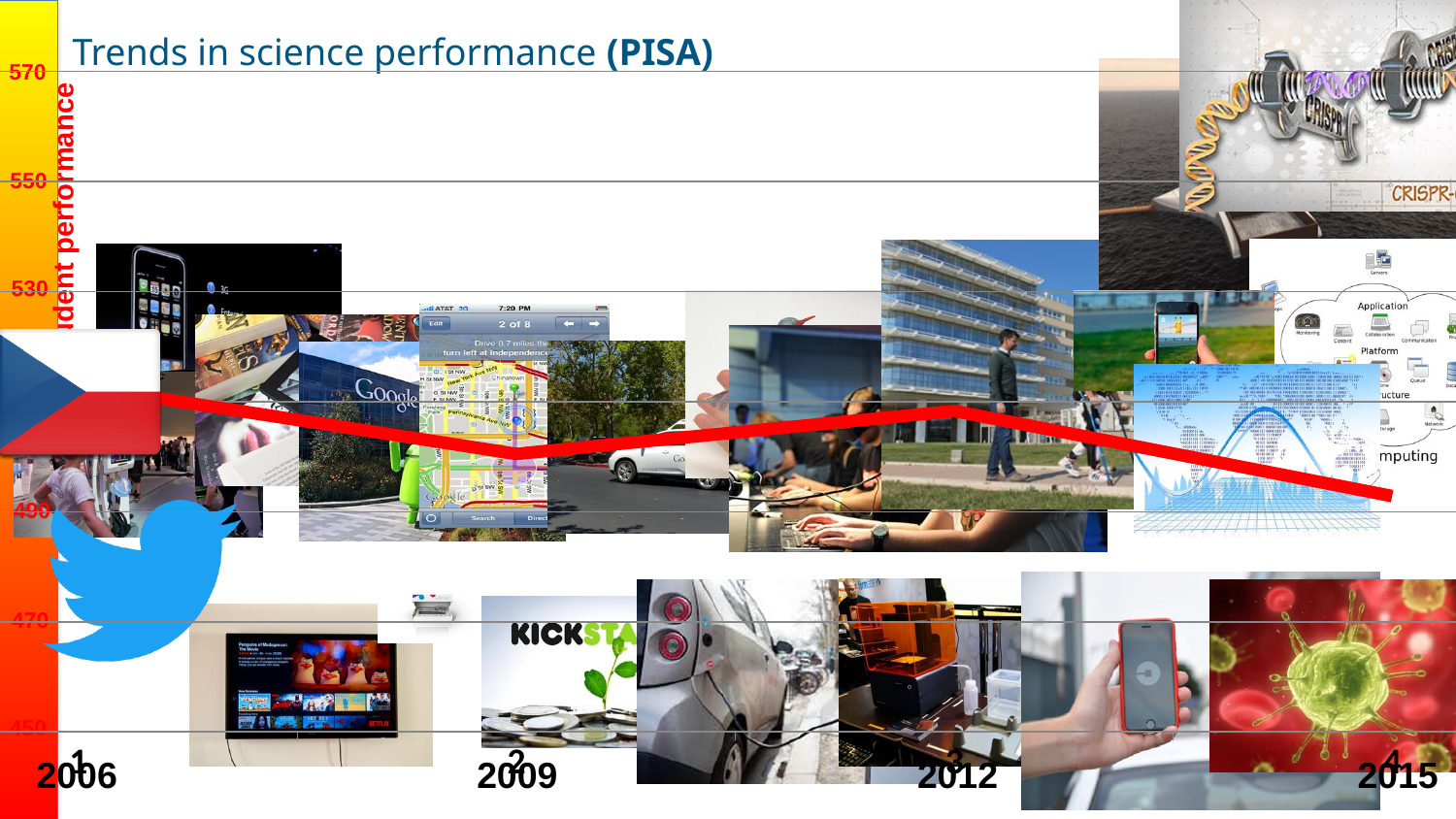
Is the value for 2009 greater or less than 490? greater Is the value for 2012 greater or less than 490? greater What kind of chart is shown on the slide? line chart What is the title of the chart? Trends in science performance (PISA) Which year has the lowest science performance value? 2015 Is the value for 2006 greater or less than 490? greater Which is larger, the value for 2009 or the value for 2015? 2009 How many years are plotted along the x axis? 4 Which is larger, the value for 2006 or the value for 2015? 2006 Overall, does the science performance line rise or fall from 2006 to 2015? fall